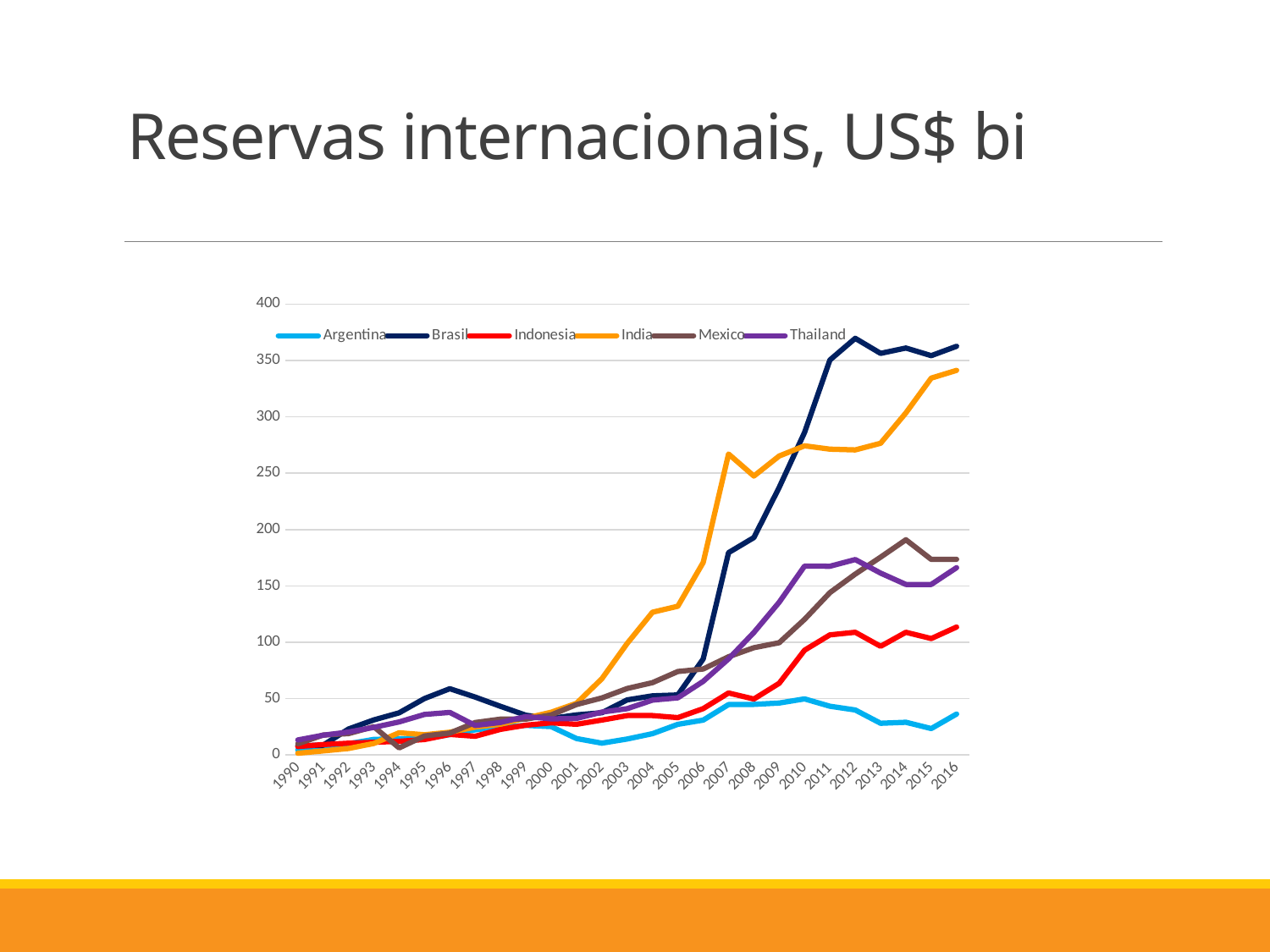
In 2007, which is larger, the value for India or the value for Brasil? India How many years are plotted along the x axis? 27 Is the value for India in 2016 greater or less than 350? less Is the value for Mexico in 2014 greater or less than 200? less How many series does the legend list? 6 Which country has the highest value in 2016? Brasil Is the value for Brasil in 2016 greater or less than 350? greater What is the title of the slide? Reservas internacionais, US$ bi Does the value for Brasil rise or fall between 2006 and 2011? rise What kind of chart is shown on the slide? line chart Which country has the lowest value in 2016? Argentina